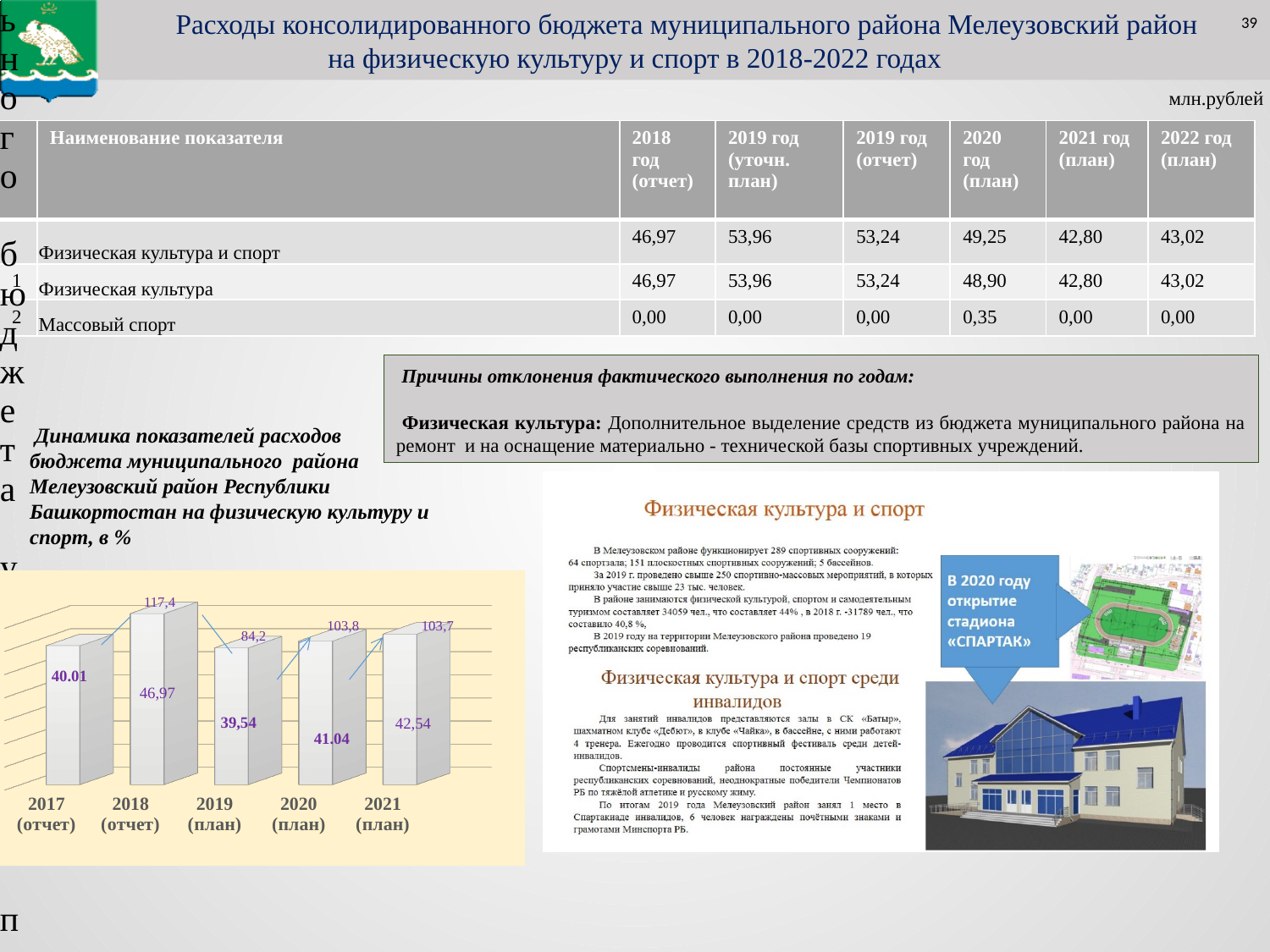
What kind of chart is used to show the dynamics of expenditures on physical culture and sport? Bar chart How many years (bars) are shown in the bar chart? 5 Which is larger in the bar chart: the value for 2020 (план) or the value for 2019 (план)? 2020 (план) Which year has the lowest bar in the chart? 2019 (план) What percentage label is shown above the 2018 (отчет) bar in the chart? 117,4 What value is shown for 2021 (план) in the bar chart? 42,54 Which year has the highest bar in the chart? 2018 (отчет) What is the difference between the 2018 (отчет) value and the 2017 (отчет) value in the bar chart? 6,96 What value is shown for 2018 (отчет) in the bar chart? 46,97 What value is shown for 2019 (план) in the bar chart? 39,54 What percentage label is shown above the 2019 (план) bar in the chart? 84,2 What value is shown for 2017 (отчет) in the bar chart? 40.01